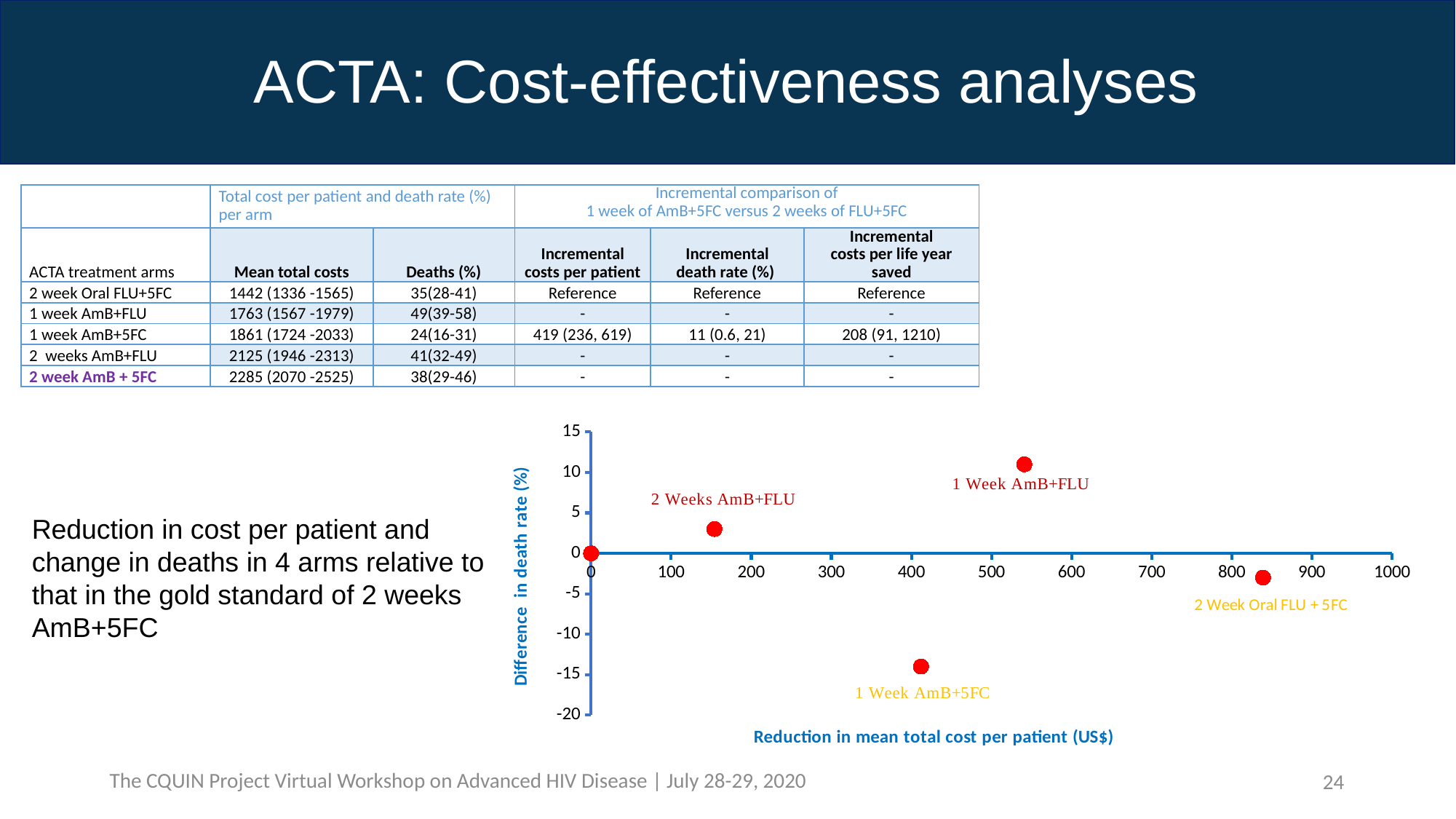
Is the difference in death rate for 1 Week AmB+5FC greater or less than -10? less How many labeled treatment arms are plotted as points on the chart? 4 Is the reduction in mean total cost per patient for 1 Week AmB+FLU greater or less than 500? greater Which labeled treatment arm has the highest difference in death rate on the chart? 1 Week AmB+FLU Which labeled treatment arm shows the largest reduction in mean total cost per patient on the chart? 2 Week Oral FLU + 5FC Which labeled treatment arm shows the smallest reduction in mean total cost per patient on the chart? 2 Weeks AmB+FLU Which has a larger reduction in mean total cost per patient on the chart, 1 Week AmB+FLU or 1 Week AmB+5FC? 1 Week AmB+FLU Is the reduction in mean total cost per patient for 2 Weeks AmB+FLU greater or less than 200? less Which labeled treatment arm has the lowest difference in death rate on the chart? 1 Week AmB+5FC What is the title of the x axis of the chart? Reduction in mean total cost per patient (US$) What kind of chart is shown on the slide? scatter chart